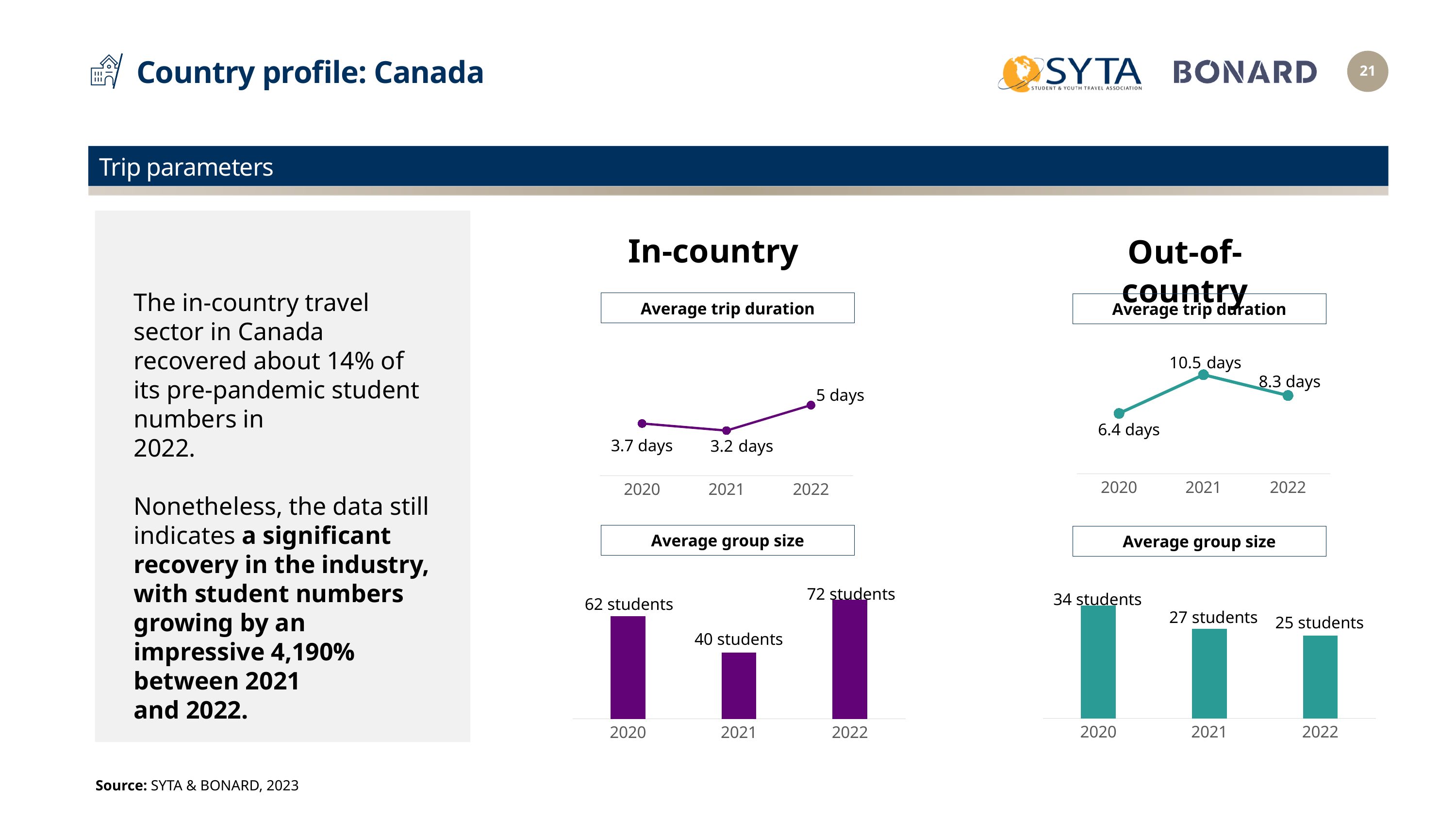
In the Out-of-country Average trip duration chart, what is the value for 2021? 10.5 days In the Out-of-country Average group size chart, do the values rise or fall from 2020 to 2022? fall In the Out-of-country Average group size chart, is the value for 2020 larger or smaller than the value for 2021? larger In the In-country Average group size chart, which year has the highest value? 2022 What kind of chart is the Out-of-country Average group size chart? bar chart In the In-country Average group size chart, what is the difference between the 2022 and 2021 values? 32 students What kind of chart is the In-country Average trip duration chart? line chart In the In-country Average trip duration chart, what is the value for 2021? 3.2 days In the In-country Average group size chart, what is the value for 2022? 72 students In the Out-of-country Average group size chart, which year has the lowest value? 2022 In the Out-of-country Average trip duration chart, which year has the highest value? 2021 In the Out-of-country Average trip duration chart, what is the difference between the 2021 and 2020 values? 4.1 days